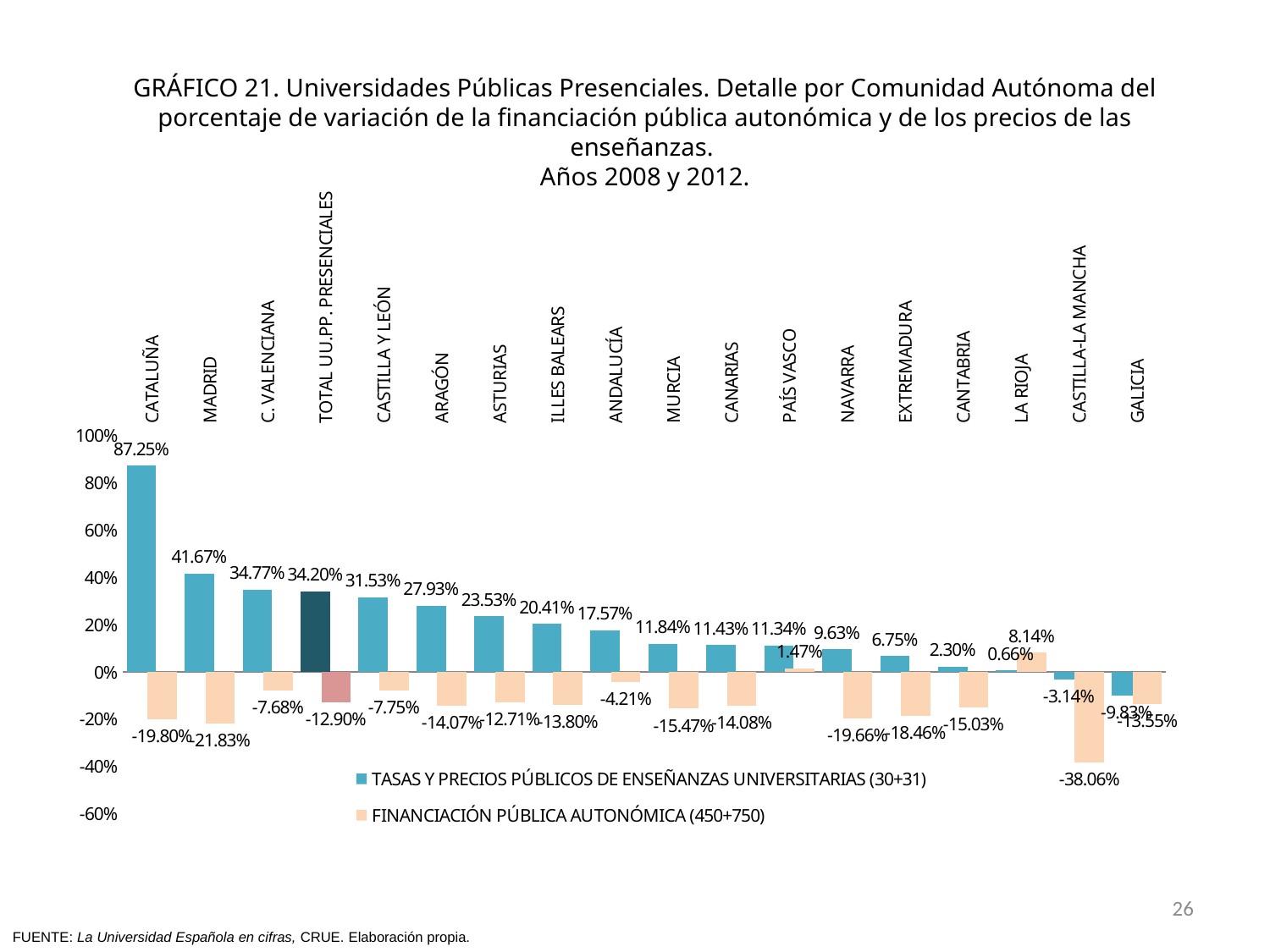
What is the value of TASAS Y PRECIOS PÚBLICOS DE ENSEÑANZAS UNIVERSITARIAS (30+31) for TOTAL UU.PP. PRESENCIALES? 34.20% Which community has the lowest value for FINANCIACIÓN PÚBLICA AUTONÓMICA (450+750)? CASTILLA-LA MANCHA Which community has the highest value for TASAS Y PRECIOS PÚBLICOS DE ENSEÑANZAS UNIVERSITARIAS (30+31)? CATALUÑA What is the value of TASAS Y PRECIOS PÚBLICOS DE ENSEÑANZAS UNIVERSITARIAS (30+31) for CATALUÑA? 87.25% How many series does the legend list? 2 Do the TASAS Y PRECIOS PÚBLICOS values rise or fall from left to right along the x axis? Fall What is the value of FINANCIACIÓN PÚBLICA AUTONÓMICA (450+750) for MADRID? -21.83% What is the difference between the TASAS Y PRECIOS PÚBLICOS values for MADRID and C. VALENCIANA? 6.90 percentage points Which has a larger TASAS Y PRECIOS PÚBLICOS value, ARAGÓN or ASTURIAS? ARAGÓN What is the value of FINANCIACIÓN PÚBLICA AUTONÓMICA (450+750) for LA RIOJA? 8.14% How many communities (categories) are shown on the x axis? 18 What kind of chart is shown on the slide? Bar chart